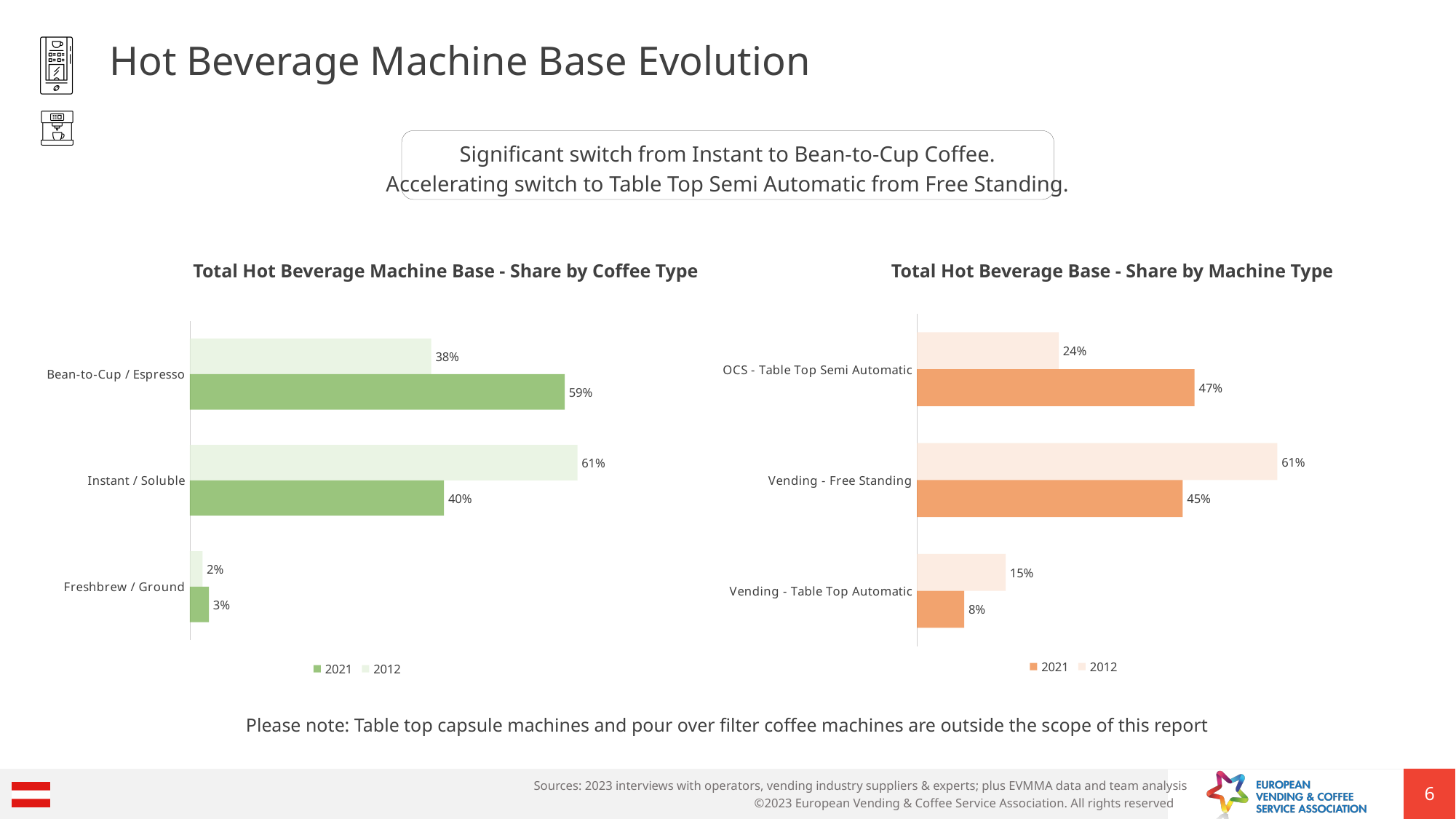
In the 'Total Hot Beverage Base - Share by Machine Type' chart, what is the difference between the 2012 and 2021 values for Vending - Free Standing? 16% In the 'Total Hot Beverage Base - Share by Machine Type' chart, is the 2021 value for Vending - Free Standing larger or smaller than its 2012 value? smaller In the 'Total Hot Beverage Base - Share by Machine Type' chart, what is the 2021 value for OCS - Table Top Semi Automatic? 47% In the 'Total Hot Beverage Machine Base - Share by Coffee Type' chart, how many series does the legend list? 2 In the 'Total Hot Beverage Machine Base - Share by Coffee Type' chart, what is the 2021 value for Bean-to-Cup / Espresso? 59% What type of chart is the 'Total Hot Beverage Machine Base - Share by Coffee Type' chart? bar chart In the 'Total Hot Beverage Machine Base - Share by Coffee Type' chart, which category has the lowest 2021 value? Freshbrew / Ground How many categories are shown in the 'Total Hot Beverage Base - Share by Machine Type' chart? 3 In the 'Total Hot Beverage Machine Base - Share by Coffee Type' chart, what is the 2012 value for Instant / Soluble? 61% In the 'Total Hot Beverage Machine Base - Share by Coffee Type' chart, what is the difference between the 2021 and 2012 values for Bean-to-Cup / Espresso? 21% In the 'Total Hot Beverage Base - Share by Machine Type' chart, what is the 2012 value for Vending - Table Top Automatic? 15% In the 'Total Hot Beverage Base - Share by Machine Type' chart, which category has the highest 2012 value? Vending - Free Standing